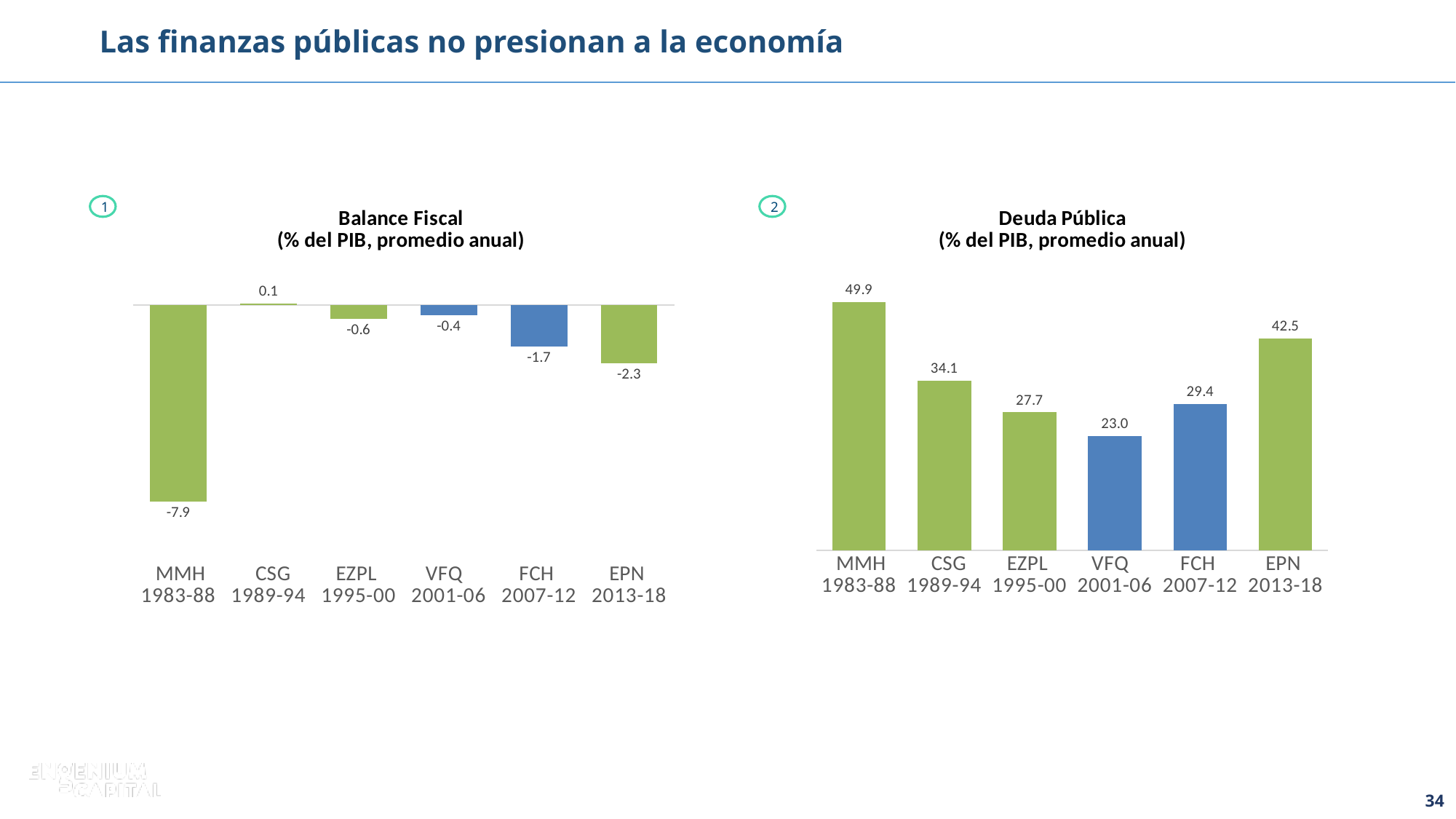
In the Deuda Pública chart, what is the difference between the values for MMH 1983-88 and EPN 2013-18? 7.4 In the Balance Fiscal chart, which period has the lowest value? MMH 1983-88 In the Deuda Pública chart, what is the value for VFQ 2001-06? 23.0 In the Balance Fiscal chart, how many periods are shown? 6 In the Balance Fiscal chart, what is the value for FCH 2007-12? -1.7 In the Deuda Pública chart, which period has the lowest value? VFQ 2001-06 In the Balance Fiscal chart, what is the value for MMH 1983-88? -7.9 In the Deuda Pública chart, which period has the highest value? MMH 1983-88 In the Balance Fiscal chart, which period has the highest value? CSG 1989-94 In the Deuda Pública chart, which is larger, the value for CSG 1989-94 or FCH 2007-12? CSG 1989-94 What kind of chart is the Deuda Pública chart? Bar chart In the Balance Fiscal chart, what is the difference between the values for EPN 2013-18 and FCH 2007-12? 0.6